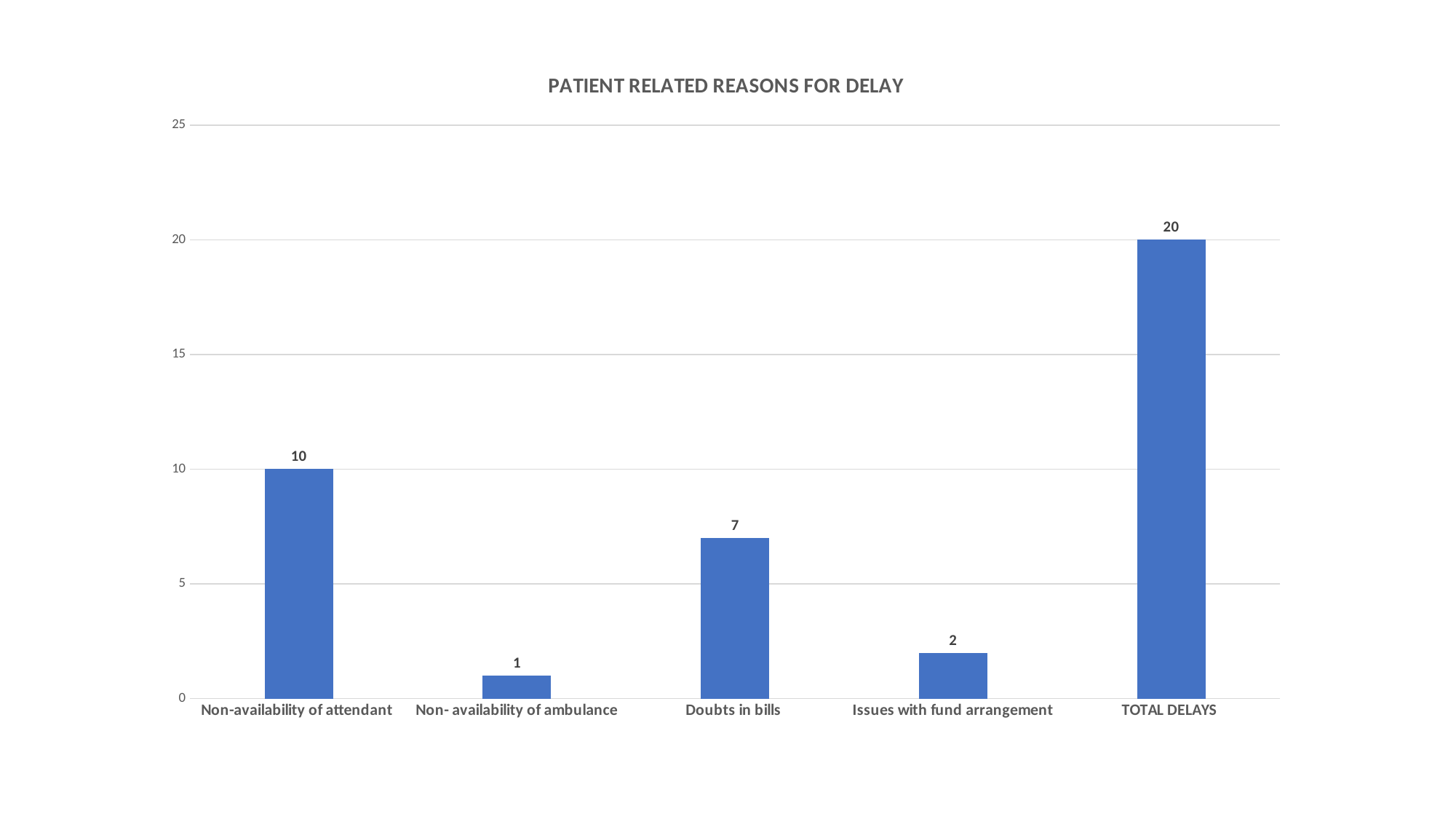
Which is larger, the value for Doubts in bills or the value for Issues with fund arrangement? Doubts in bills What is the title of the chart? PATIENT RELATED REASONS FOR DELAY Is the value for Non-availability of attendant greater or less than 5? greater What is the difference between the values for Non-availability of attendant and Doubts in bills? 3 What is the value for Non-availability of attendant? 10 What kind of chart is shown on the slide? bar chart What is the value for TOTAL DELAYS? 20 Which category has the lowest value? Non- availability of ambulance Which category has the highest value? TOTAL DELAYS What is the value for Issues with fund arrangement? 2 How many categories are shown on the x axis? 5 What is the value for Doubts in bills? 7